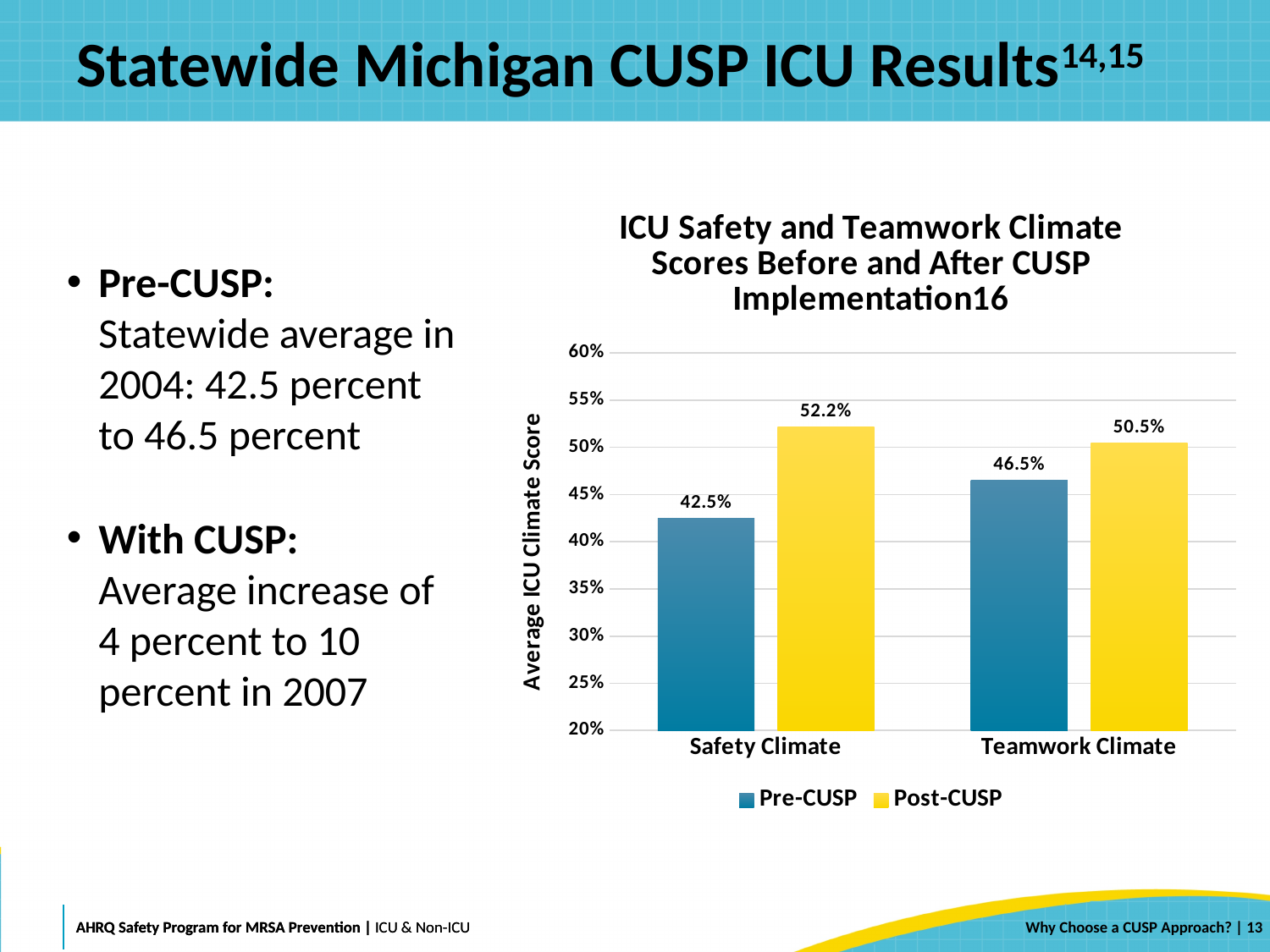
What is the Pre-CUSP value for Teamwork Climate? 46.5% What is the Post-CUSP value for Safety Climate? 52.2% What is the Post-CUSP value for Teamwork Climate? 50.5% What is the difference between the Post-CUSP and Pre-CUSP values for Safety Climate? 9.7% Which bar has the highest value on the chart? Post-CUSP Safety Climate What kind of chart is shown on the slide? Bar chart How many series does the legend list? 2 Which bar has the lowest value on the chart? Pre-CUSP Safety Climate What is the Pre-CUSP value for Safety Climate? 42.5% What is the difference between the Post-CUSP and Pre-CUSP values for Teamwork Climate? 4.0% Which is larger: the Pre-CUSP value for Teamwork Climate or the Pre-CUSP value for Safety Climate? Pre-CUSP Teamwork Climate What is the label of the vertical axis? Average ICU Climate Score